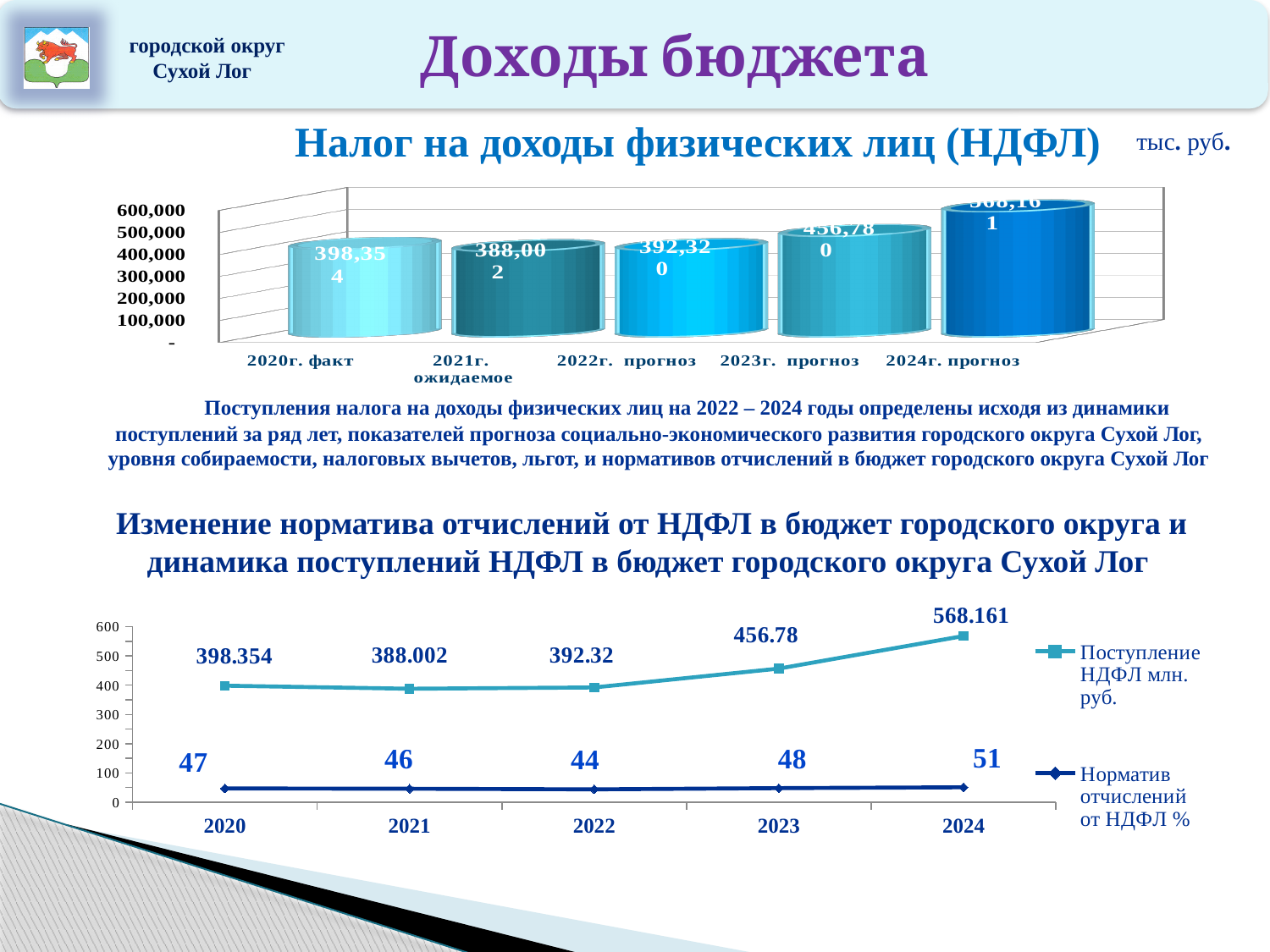
In the bottom line chart, what is the difference between the 'Норматив отчислений от НДФЛ %' values for 2024 and 2020? 4 How many categories are shown on the x axis of the top chart 'Налог на доходы физических лиц (НДФЛ)'? 5 In the top chart 'Налог на доходы физических лиц (НДФЛ)', what is the value for '2020г. факт'? 398,354 In the bottom line chart, what is the value of 'Норматив отчислений от НДФЛ %' for 2022? 44 In the top chart 'Налог на доходы физических лиц (НДФЛ)', what is the value for '2023г. прогноз'? 456,780 In the top chart 'Налог на доходы физических лиц (НДФЛ)', is the value for '2022г. прогноз' greater or less than 500,000? less In the top chart 'Налог на доходы физических лиц (НДФЛ)', which category has the highest value? 2024г. прогноз In the bottom line chart, what is the value of 'Поступление НДФЛ млн. руб.' for 2024? 568.161 In the top chart 'Налог на доходы физических лиц (НДФЛ)', which category has the lowest value? 2021г. ожидаемое What kind of chart is the top chart titled 'Налог на доходы физических лиц (НДФЛ)'? bar chart In the bottom line chart, does 'Поступление НДФЛ млн. руб.' rise or fall from 2022 to 2024? rise How many series does the legend of the bottom line chart list? 2